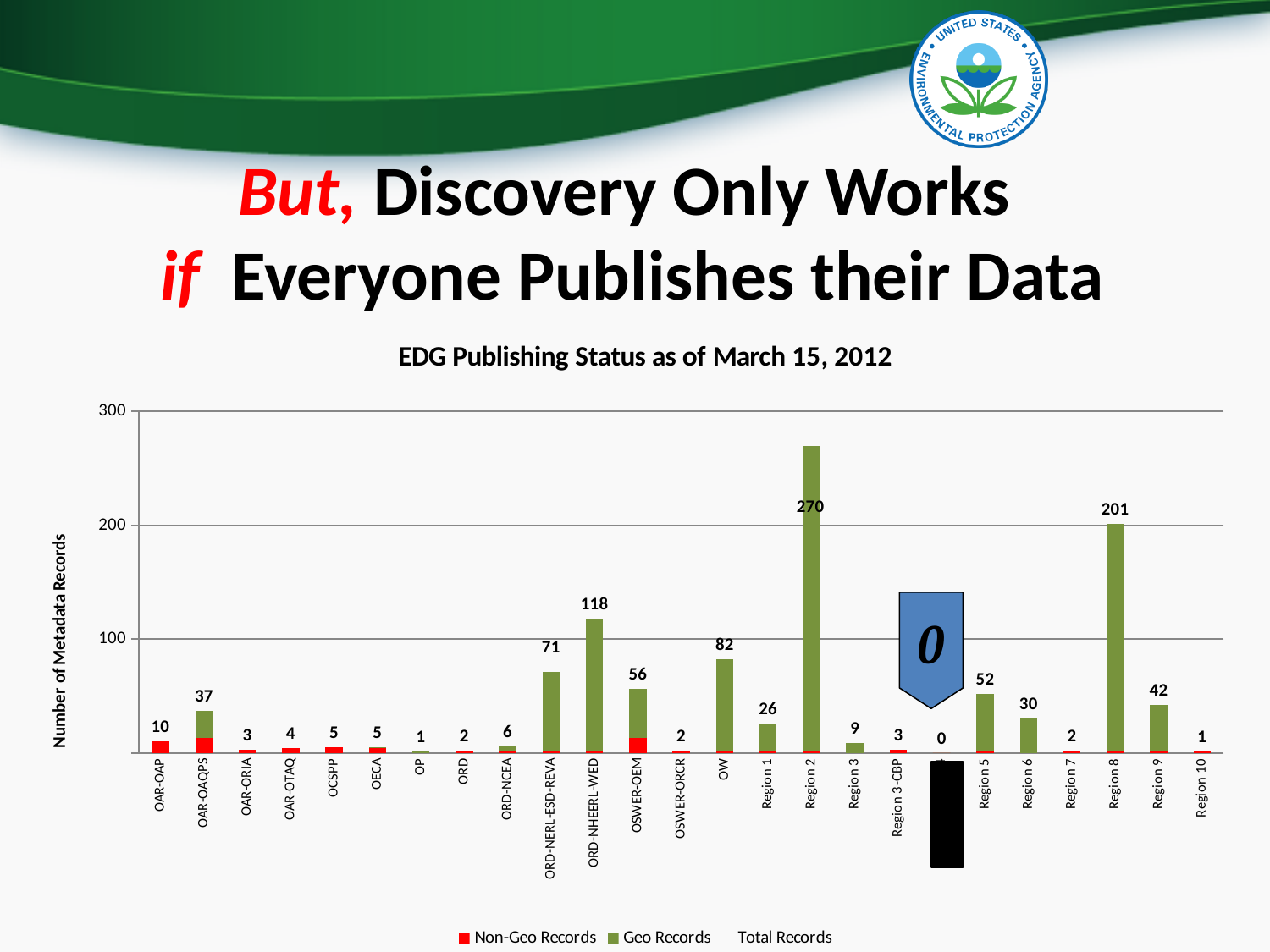
What is the total number of metadata records for Region 2? 270 What is the total number of metadata records for OAR-OAQPS? 37 What is the total number of metadata records for Region 8? 201 What is the difference in total records between Region 2 and Region 8? 69 Which category has the highest total number of metadata records? Region 2 What is the total number of metadata records for OW? 82 What is the title of the chart? EDG Publishing Status as of March 15, 2012 What kind of chart is shown on the slide? Bar chart Which has more total records, OW or ORD-NERL-ESD-REVA? OW Is the total for Region 2 greater or less than 200? greater How many series does the legend list? 3 What is the total number of metadata records for ORD-NHEERL-WED? 118